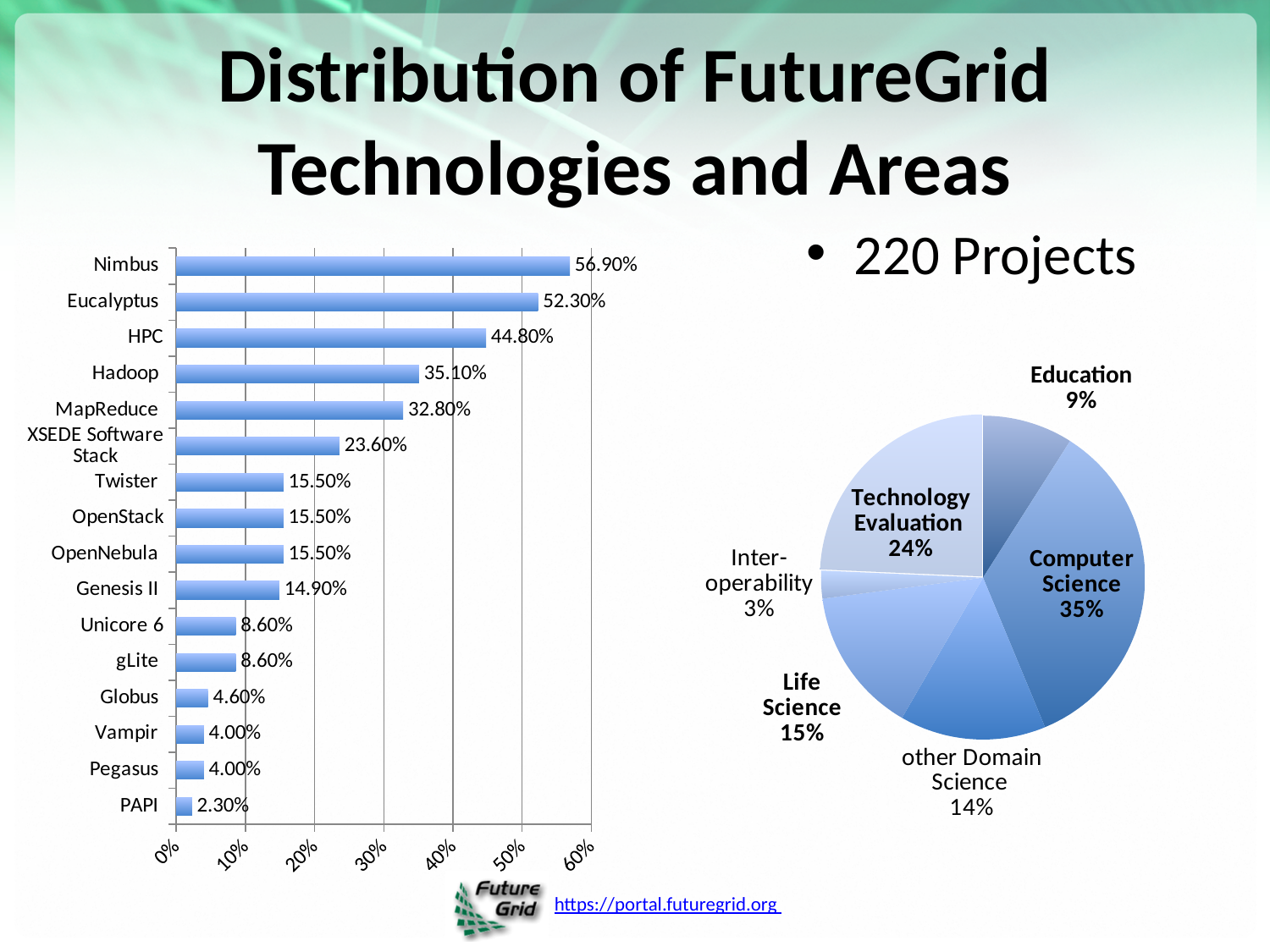
In the bar chart on the left, what is the difference between the values for Eucalyptus and HPC? 7.50% In the bar chart on the left, which is larger, the value for Hadoop or the value for MapReduce? Hadoop In the bar chart on the left, which technology has the lowest value? PAPI In the pie chart on the right, what share does Inter-operability have? 3% What kind of chart is the chart on the left of the slide? Bar chart In the bar chart on the left, what is the value for Nimbus? 56.90% In the pie chart on the right, which area has the largest share? Computer Science How many technologies are shown in the bar chart on the left? 16 In the pie chart on the right, what share does Computer Science have? 35% How many slices does the pie chart on the right have? 6 In the bar chart on the left, what is the value for XSEDE Software Stack? 23.60% In the bar chart on the left, which technology has the highest value? Nimbus